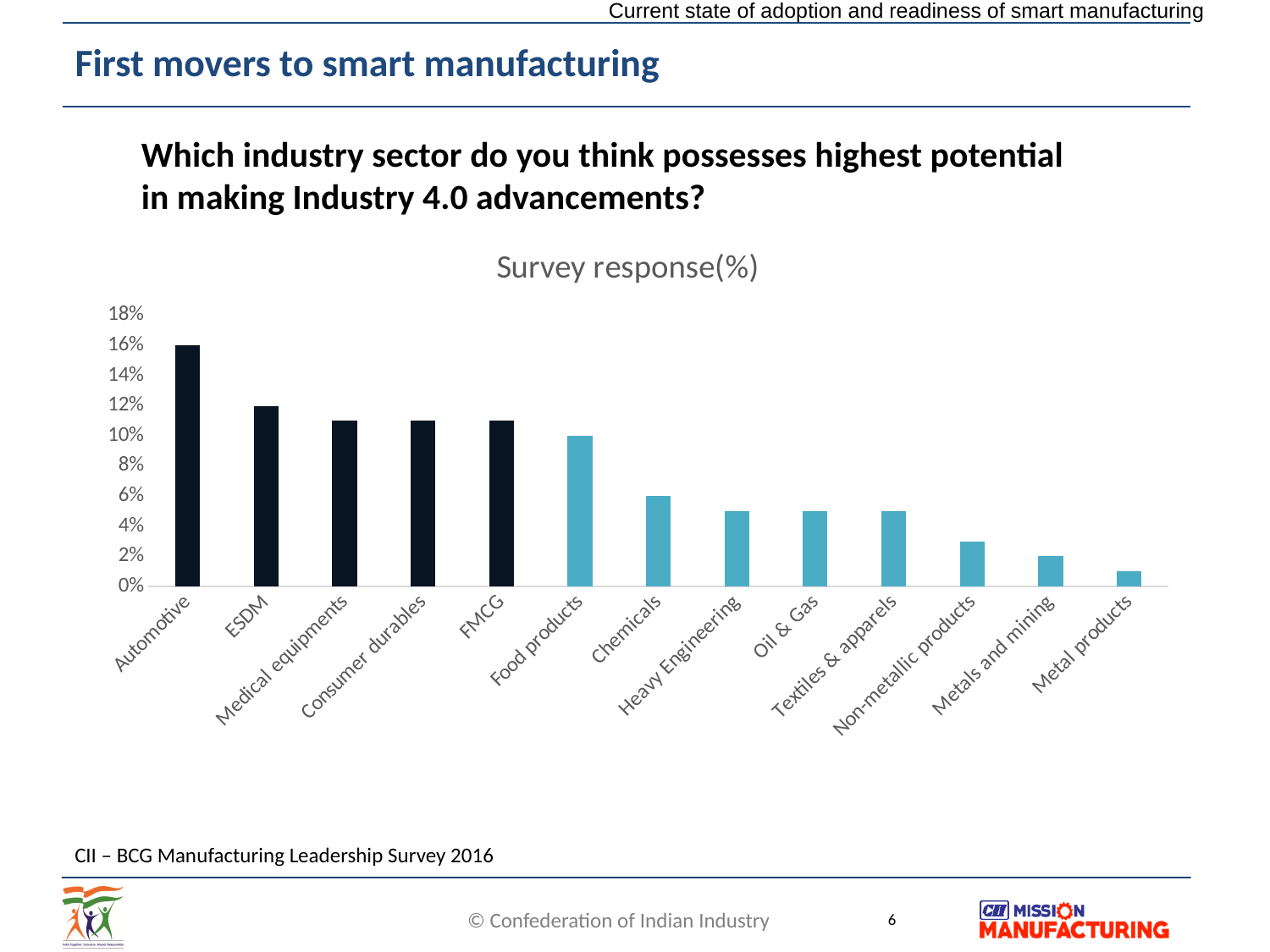
What is the survey response for Food products? 10% Which industry sector has the highest survey response? Automotive Which industry sector has the lowest survey response? Metal products Which has a larger survey response, ESDM or Chemicals? ESDM What kind of chart is shown on the slide? Bar chart Is the value for Non-metallic products greater or less than 2%? greater Is the value for Heavy Engineering greater or less than 6%? less Is the value for Medical equipments greater or less than 10%? greater What is the survey response for Automotive? 16% Do the values rise or fall moving from left to right along the x axis? Fall What is the title of the chart? Survey response(%) How many industry sectors are shown on the x axis of the chart? 13